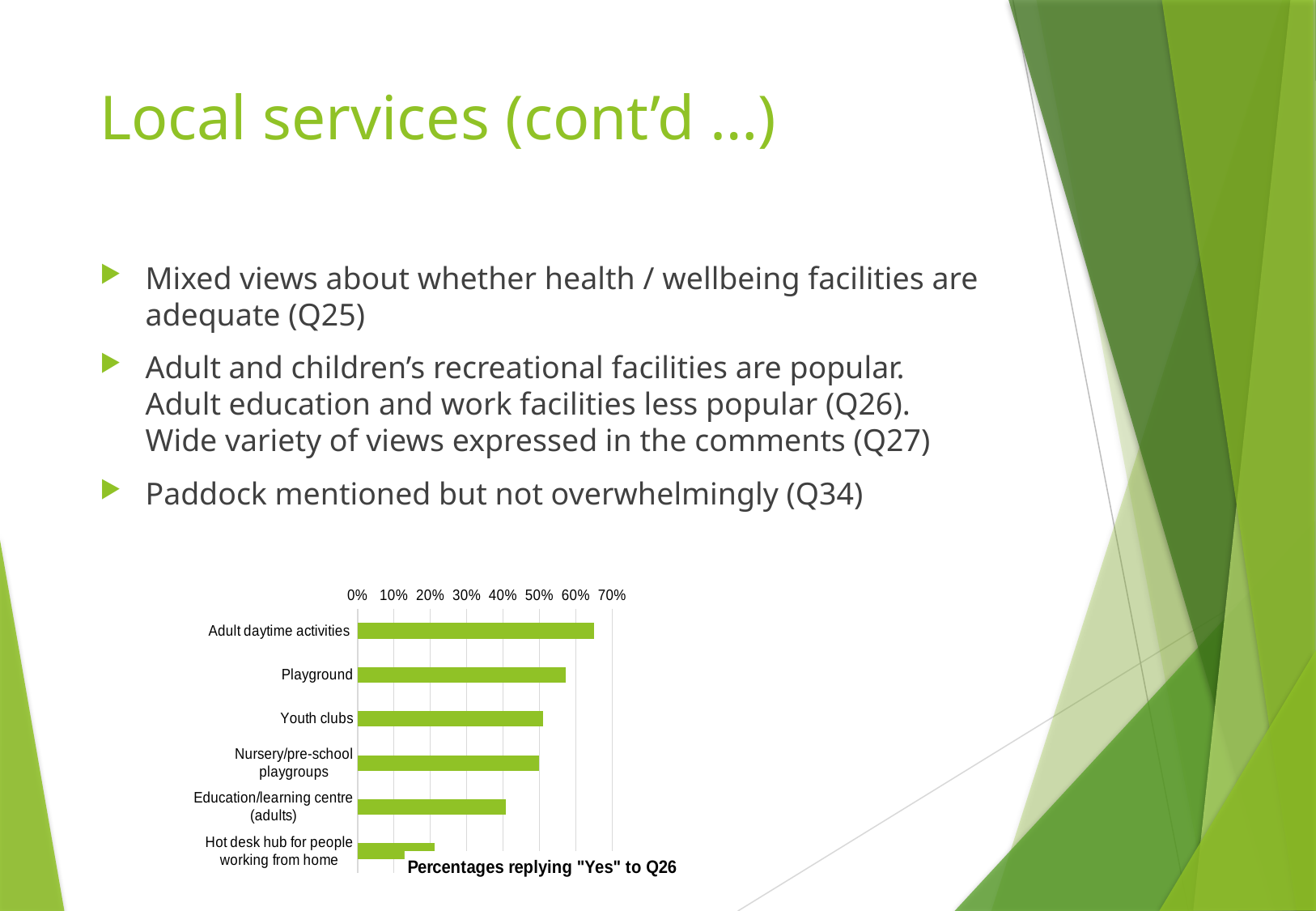
Is the value for Playground greater or less than 50%? greater Which is larger, the value for Education/learning centre (adults) or the value for Hot desk hub for people working from home? Education/learning centre (adults) Is the value for Hot desk hub for people working from home greater or less than 30%? less What is the title of the chart? Percentages replying "Yes" to Q26 How many categories does the chart show? 6 What kind of chart is shown on the slide? bar chart Is the value for Education/learning centre (adults) greater or less than 50%? less Which is larger, the value for Playground or the value for Youth clubs? Playground Which category has the lowest percentage replying "Yes" to Q26? Hot desk hub for people working from home Which category has the highest percentage replying "Yes" to Q26? Adult daytime activities